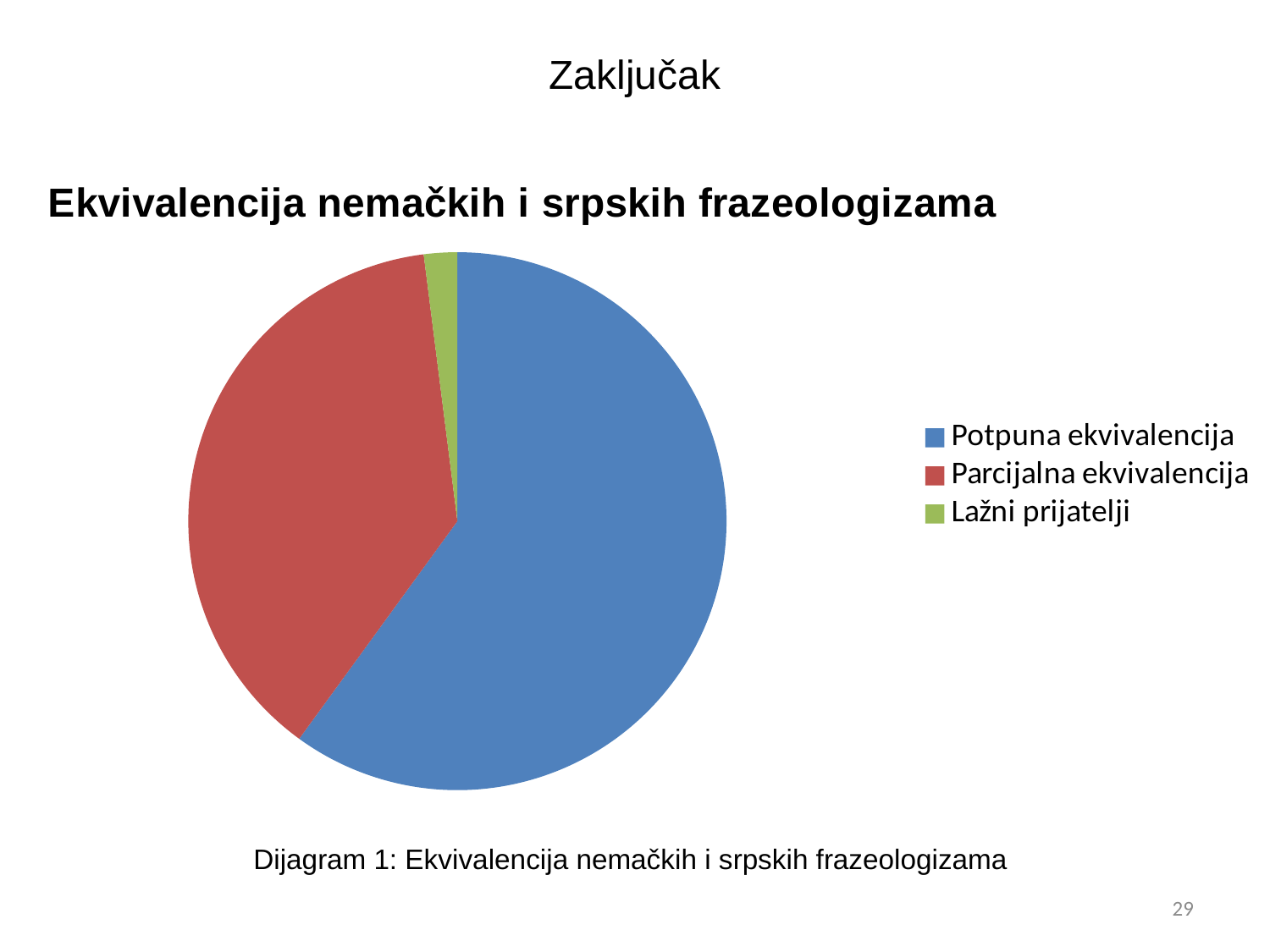
How many entries does the legend of the pie chart list? 3 What is the title of the chart shown on the slide? Ekvivalencija nemačkih i srpskih frazeologizama Which slice is larger: Potpuna ekvivalencija or Parcijalna ekvivalencija? Potpuna ekvivalencija Which category has the largest slice of the pie chart? Potpuna ekvivalencija What colour is the slice for Lažni prijatelji in the pie chart? Green How many slices does the pie chart have? 3 Which slice is smaller: Potpuna ekvivalencija or Lažni prijatelji? Lažni prijatelji Which slice is larger: Parcijalna ekvivalencija or Lažni prijatelji? Parcijalna ekvivalencija What kind of chart is shown on the slide? Pie chart Which category has the smallest slice of the pie chart? Lažni prijatelji